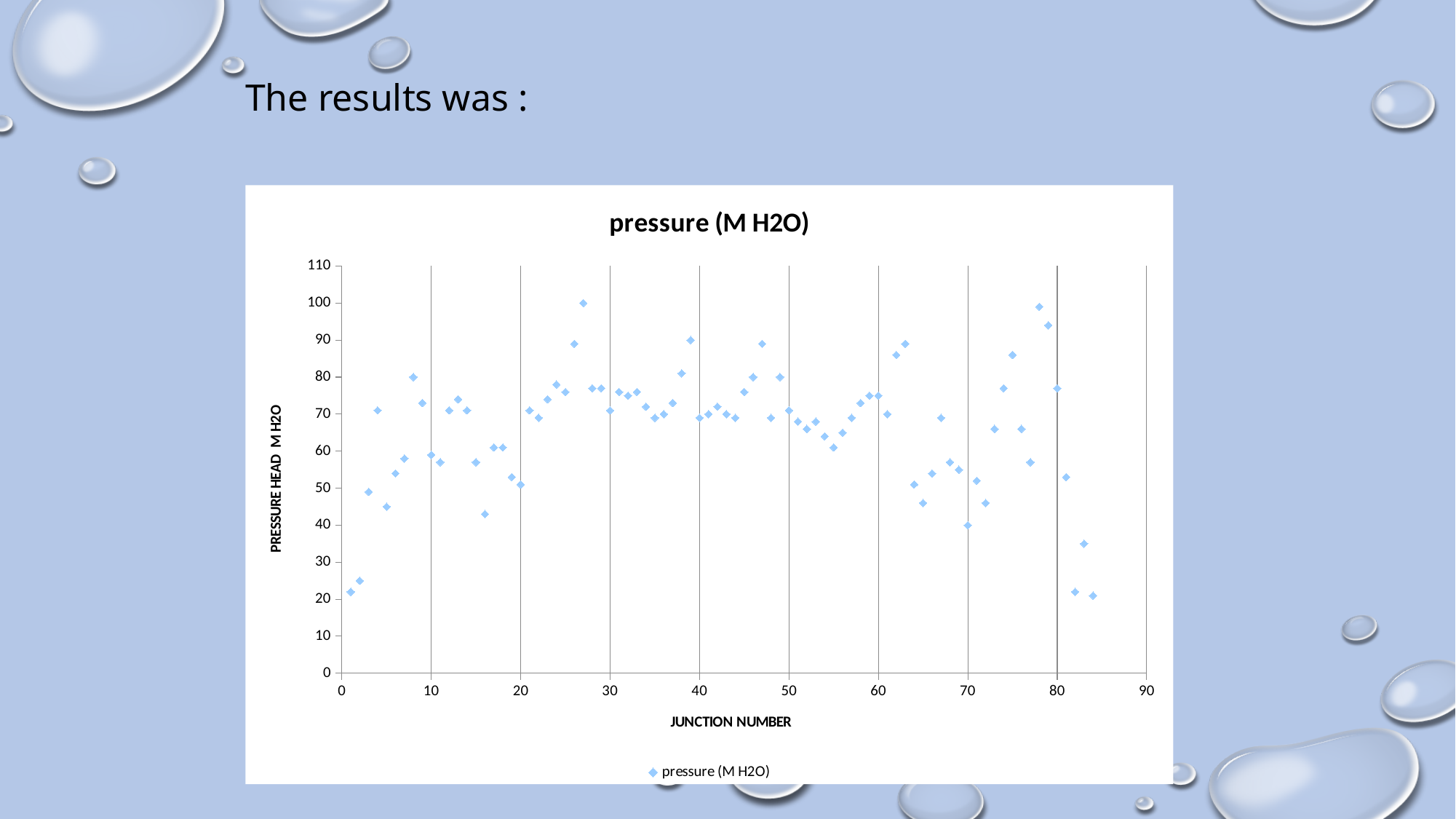
Which has the larger pressure value, junction number 27 or junction number 70? junction number 27 What kind of chart is shown on the slide? scatter chart Is the pressure value at junction number 70 greater or less than 50? less What is the label on the x axis of the chart? JUNCTION NUMBER Is the pressure value at junction number 84 greater or less than 30? less Is the pressure value at junction number 16 greater or less than 50? less Do the pressure values rise or fall from junction number 80 to junction number 84? fall How many series does the chart legend list? 1 Which has the larger pressure value, junction number 1 or junction number 8? junction number 8 What is the title of the chart? pressure (M H2O)